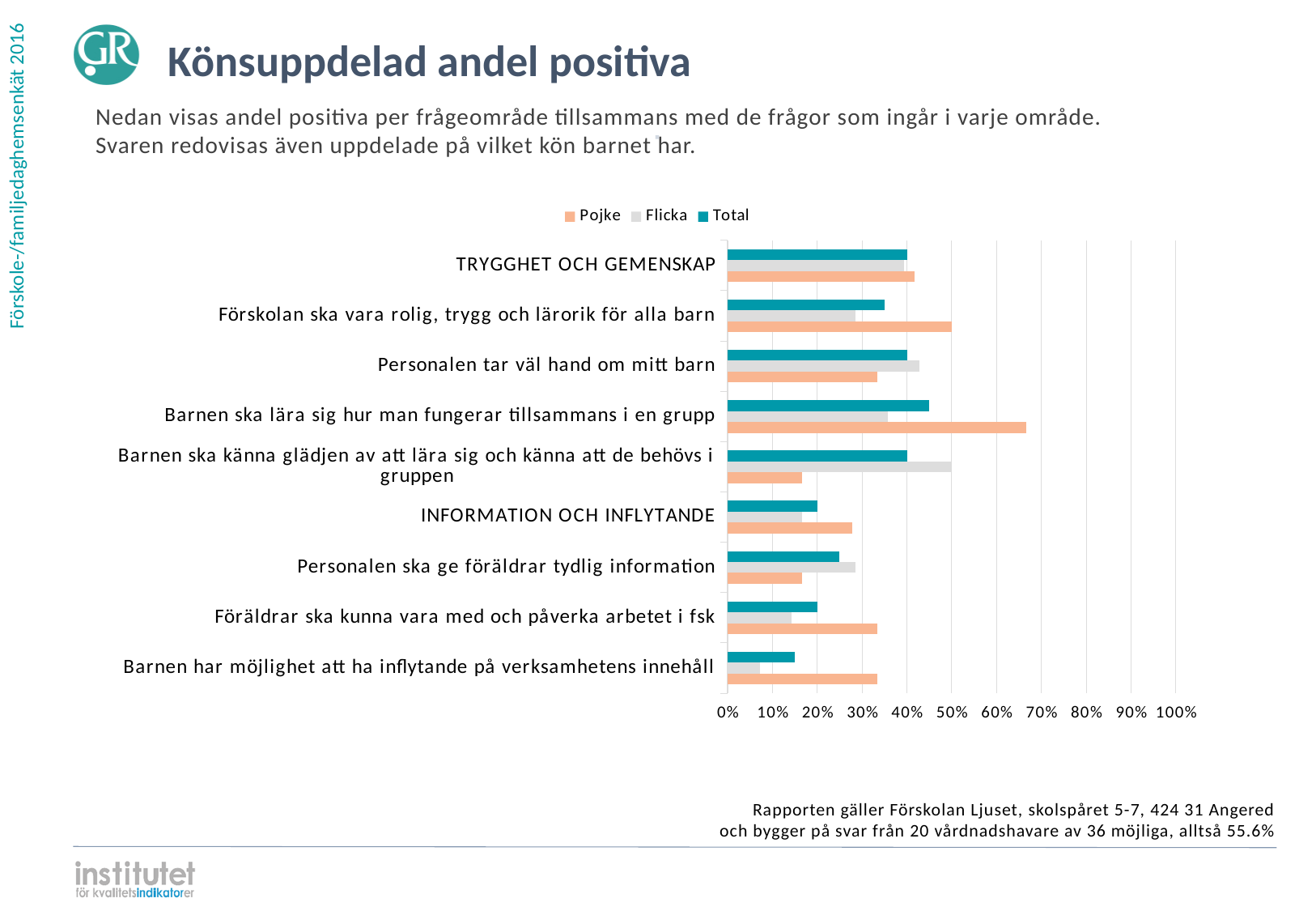
Is the Flicka value for 'Barnen har möjlighet att ha inflytande på verksamhetens innehåll' greater or less than 10%? less For 'Barnen ska känna glädjen av att lära sig och känna att de behövs i gruppen', which series has the larger value, Pojke or Flicka? Flicka Is the Total value for 'INFORMATION OCH INFLYTANDE' greater or less than 30%? less What kind of chart is shown on the slide? bar chart Is the Total value for 'TRYGGHET OCH GEMENSKAP' greater or less than 30%? greater How many categories are plotted on the y axis of the chart? 9 For 'Förskolan ska vara rolig, trygg och lärorik för alla barn', which series has the larger value, Pojke or Flicka? Pojke How many series does the legend list? 3 What are the three series listed in the chart legend? Pojke, Flicka, Total Which category has the lowest value for the Flicka series? Barnen har möjlighet att ha inflytande på verksamhetens innehåll Which category has the highest value for the Pojke series? Barnen ska lära sig hur man fungerar tillsammans i en grupp